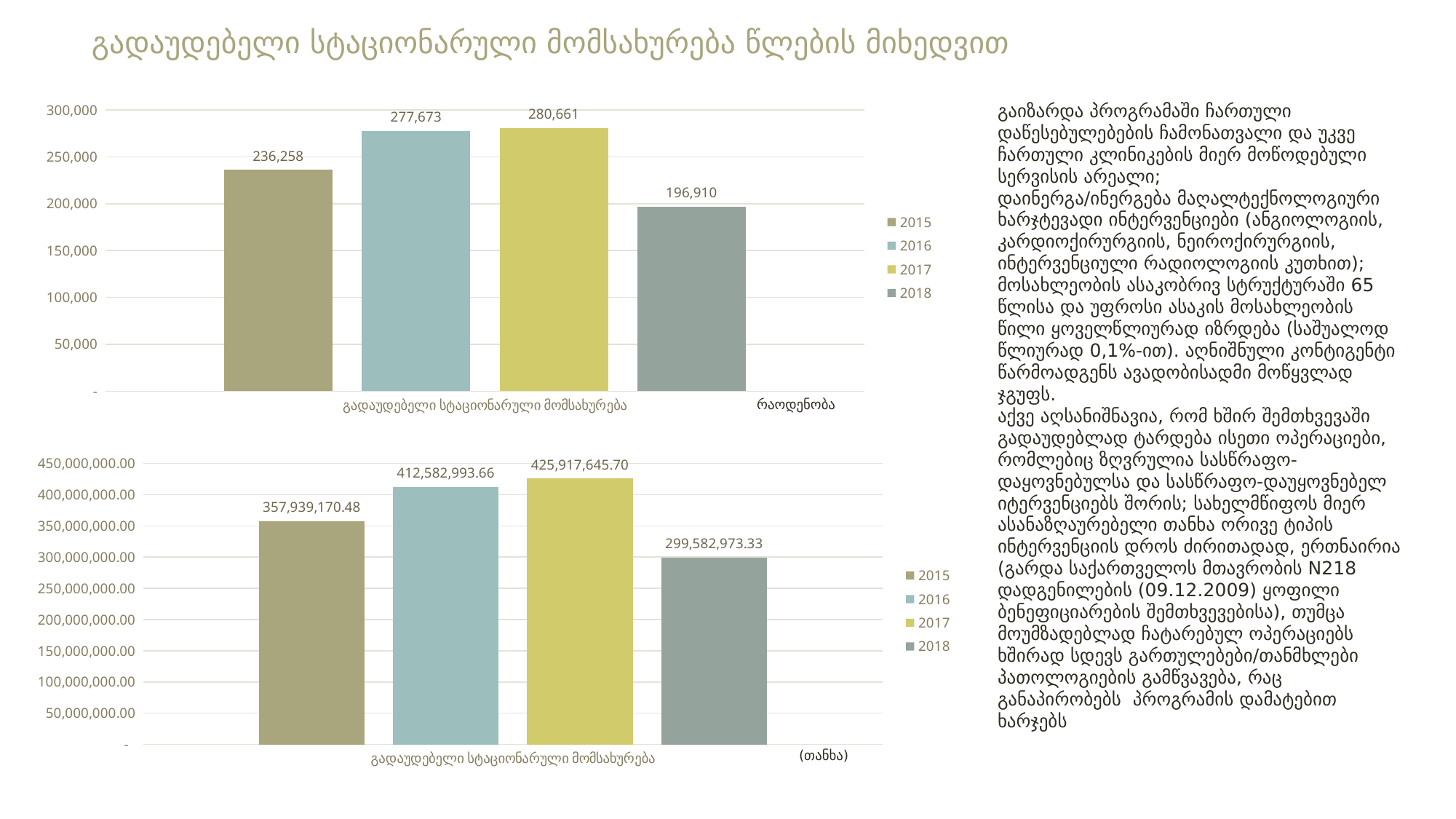
In the bottom chart, which year has the lowest value? 2018 In the top chart, what is the value for 2018? 196,910 What type of chart is the bottom chart? bar chart In the top chart, what is the difference between the 2016 and 2015 values? 41,415 In the bottom chart, what is the difference between the 2017 and 2016 values? 13,334,652.04 In the bottom chart, what is the value for 2017? 425,917,645.70 In the bottom chart, what is the value for 2015? 357,939,170.48 In the top chart, what is the value for 2016? 277,673 In the top chart, which year has the highest value? 2017 In the top chart, which year has the lowest value? 2018 In the bottom chart, is the value for 2016 larger or smaller than the value for 2018? larger In the top chart, how many series does the legend list? 4